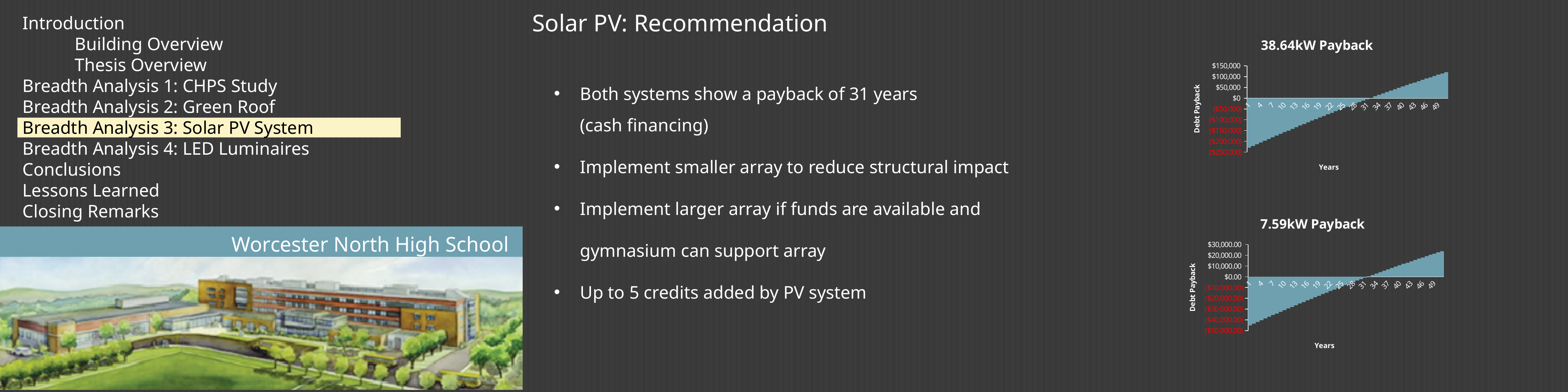
What kind of chart is the "38.64kW Payback" chart? bar chart What is the highest tick value shown on the y axis of the "38.64kW Payback" chart? $150,000 In the "7.59kW Payback" chart, is the value at year 49 greater or less than $10,000.00? greater In the "38.64kW Payback" chart, is the value at year 22 greater or less than $0? less In the "38.64kW Payback" chart, is the value at year 1 greater or less than ($150,000)? less In the "7.59kW Payback" chart, do the values rise or fall as the years increase? rise In the "38.64kW Payback" chart, do the values rise or fall as the years increase? rise What is the y-axis title of the "7.59kW Payback" chart? Debt Payback How many year labels are shown on the x axis of the "38.64kW Payback" chart? 17